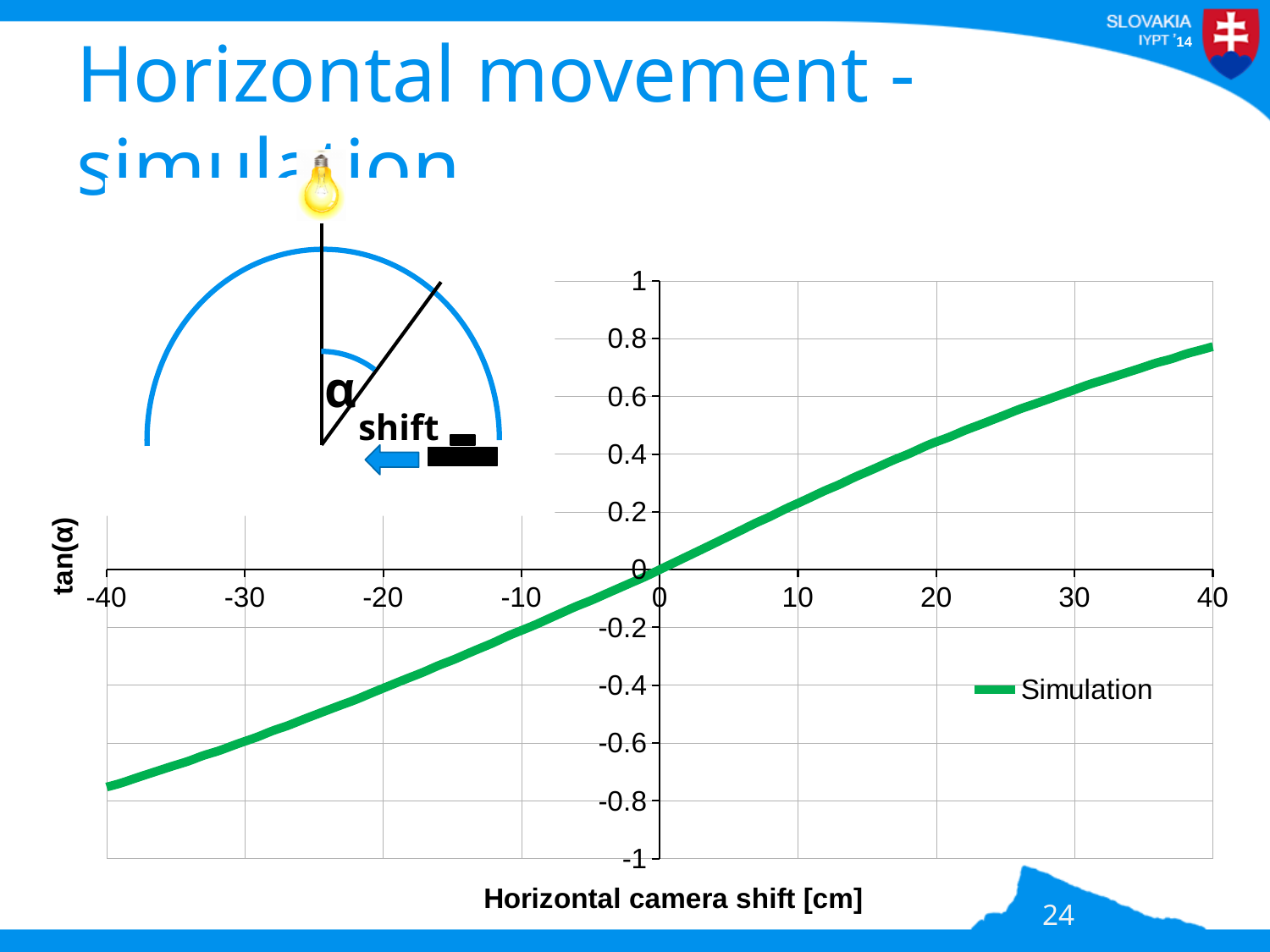
What is the name of the series shown in the chart legend? Simulation Which is larger: tan(α) at a camera shift of 40 cm or at a camera shift of 10 cm? 40 cm At which horizontal camera shift shown on the axis does the Simulation curve reach its lowest value? -40 Is the value of tan(α) at a horizontal camera shift of -40 cm greater or less than -0.6? less Is the value of tan(α) at a horizontal camera shift of 40 cm greater or less than 0.6? greater Is the value of tan(α) at a horizontal camera shift of -20 cm greater or less than -0.2? less What kind of chart is shown on the slide? line chart What is the title of the horizontal axis of the chart? Horizontal camera shift [cm] How many series does the chart legend list? 1 Does the Simulation curve rise or fall as the horizontal camera shift increases from -40 to 40 cm? rises What is the value of tan(α) at a horizontal camera shift of 0 cm? 0